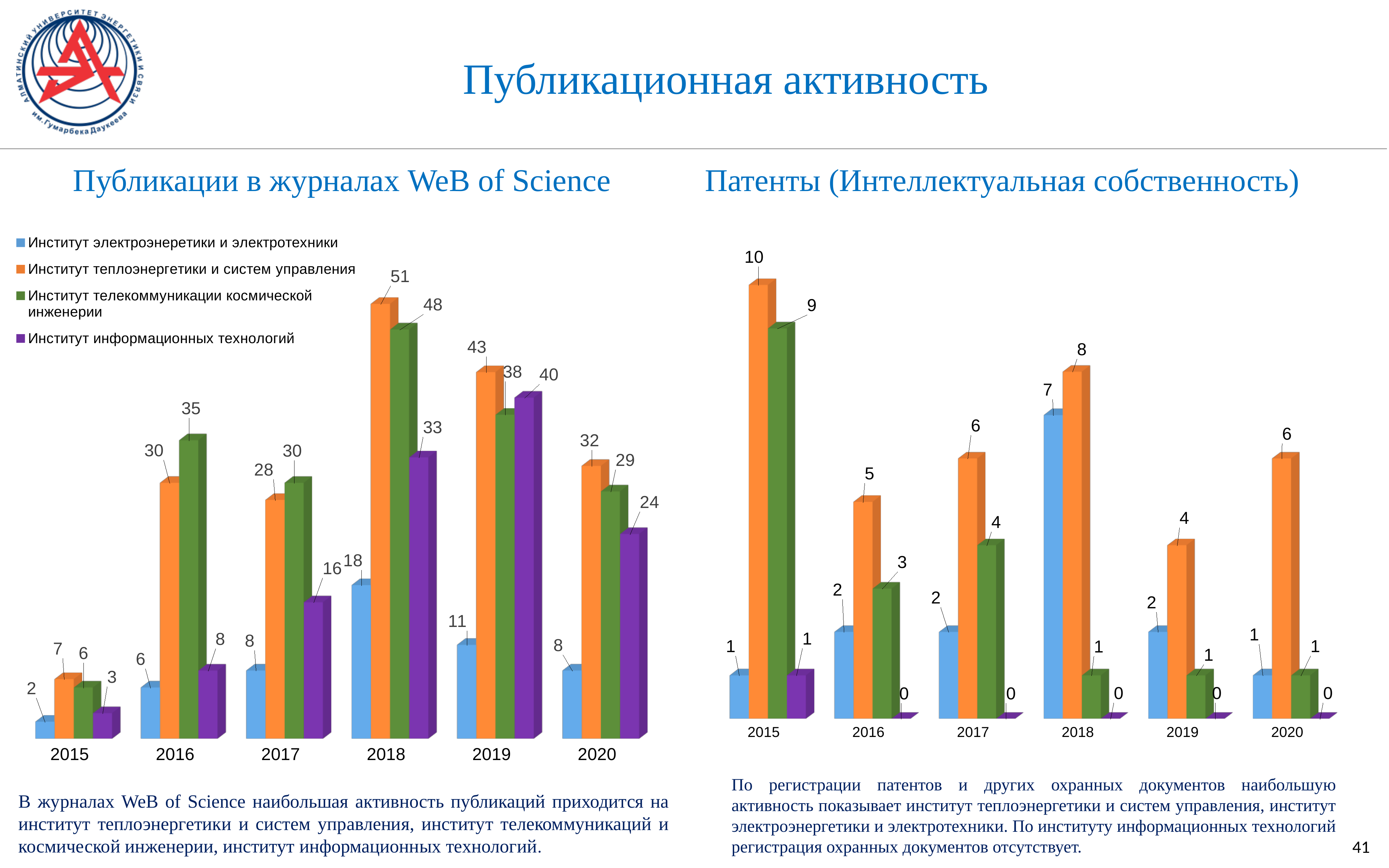
In the chart 'Публикации в журналах WeB of Science', which is larger in 2016: Институт теплоэнергетики и систем управления or Институт телекоммуникации космической инженерии? Институт телекоммуникации космической инженерии How many series does the legend of the chart 'Публикации в журналах WeB of Science' list? 4 In the chart 'Публикации в журналах WeB of Science', what is the difference between Институт теплоэнергетики и систем управления and Институт электроэнеретики и электротехники in 2020? 24 In the chart 'Патенты (Интеллектуальная собственность)', what is the value of the purple bar in 2020? 0 In the chart 'Публикации в журналах WeB of Science', what is the value for Институт информационных технологий in 2019? 40 In the chart 'Публикации в журналах WeB of Science', in which year is the value for Институт электроэнеретики и электротехники lowest? 2015 In the chart 'Патенты (Интеллектуальная собственность)', what is the value of the blue bar in 2018? 7 In the chart 'Публикации в журналах WeB of Science', what is the value for Институт теплоэнергетики и систем управления in 2018? 51 What kind of chart is 'Патенты (Интеллектуальная собственность)'? bar chart How many years are shown on the x axis of the chart 'Публикации в журналах WeB of Science'? 6 In the chart 'Публикации в журналах WeB of Science', in which year does Институт телекоммуникации космической инженерии reach its highest value? 2018 In the chart 'Патенты (Интеллектуальная собственность)', what is the value of the orange bar in 2015? 10